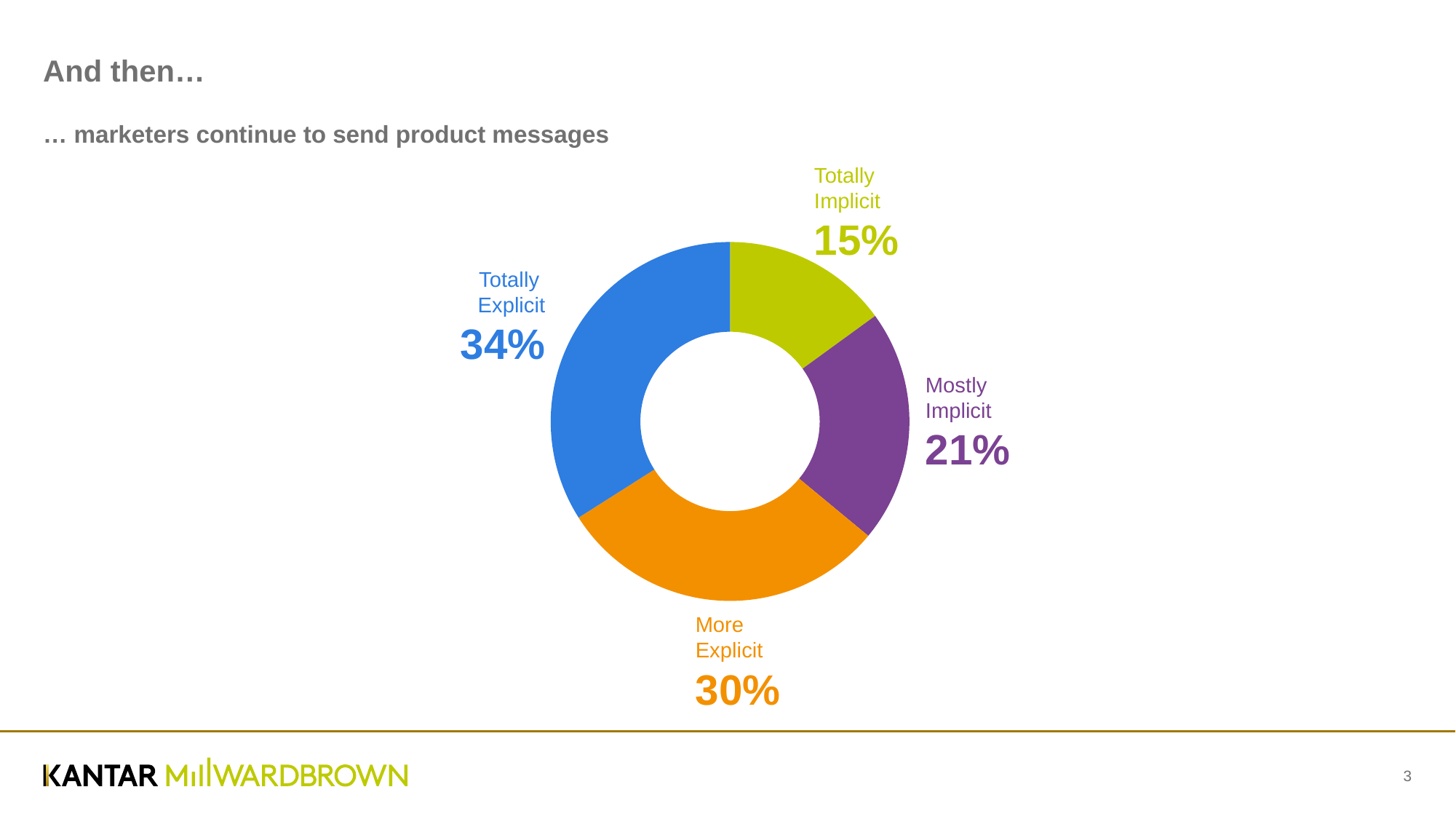
What percentage of product messages are Mostly Implicit? 21% What percentage of product messages are Totally Explicit? 34% Which category has the largest share of the chart? Totally Explicit What percentage of product messages are More Explicit? 30% Which category has the smallest share of the chart? Totally Implicit Which is larger, the share for More Explicit or the share for Mostly Implicit? More Explicit What is the difference in percentage points between Totally Explicit and Totally Implicit? 19 How many categories are shown in the chart? 4 What kind of chart is shown on the slide? Doughnut (pie) chart What colour is the Mostly Implicit segment? Purple What percentage of product messages are Totally Implicit? 15% What is the difference in percentage points between More Explicit and Mostly Implicit? 9